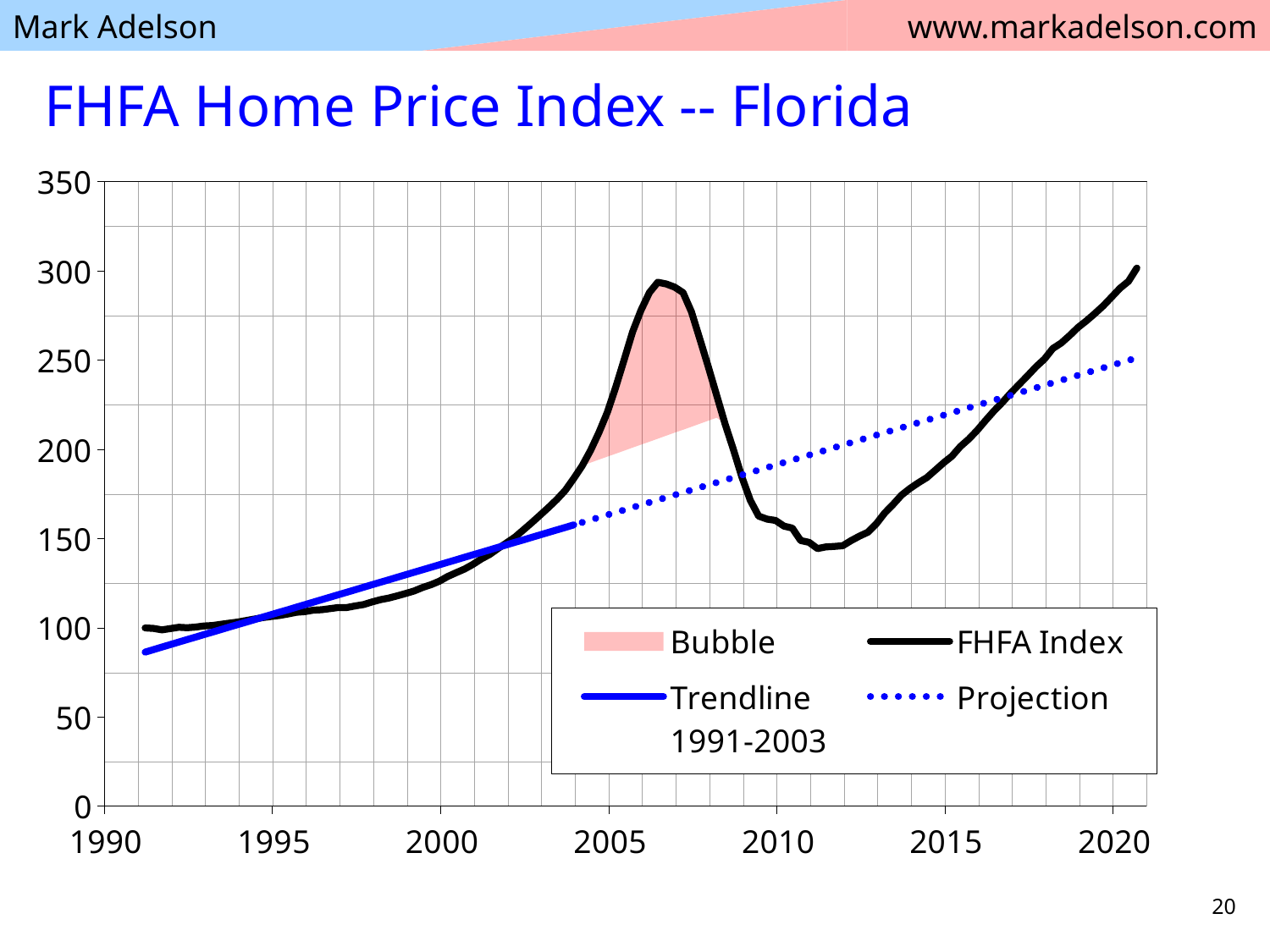
In 2020, which is larger, the FHFA Index or the Projection? FHFA Index How many entries does the legend list? 4 Is the value of the FHFA Index in 2011 greater or less than 200? less Is the value of the FHFA Index in 2007 greater or less than 250? greater Is the value of the Trendline 1991-2003 in 1991 greater or less than 100? less Does the FHFA Index rise or fall between 2012 and 2020? rise What is the title of the chart? FHFA Home Price Index -- Florida What kind of chart is shown on the slide? line chart Which is larger, the FHFA Index in 2007 or the FHFA Index in 2011? FHFA Index in 2007 Which legend entry is drawn as a dotted line? Projection